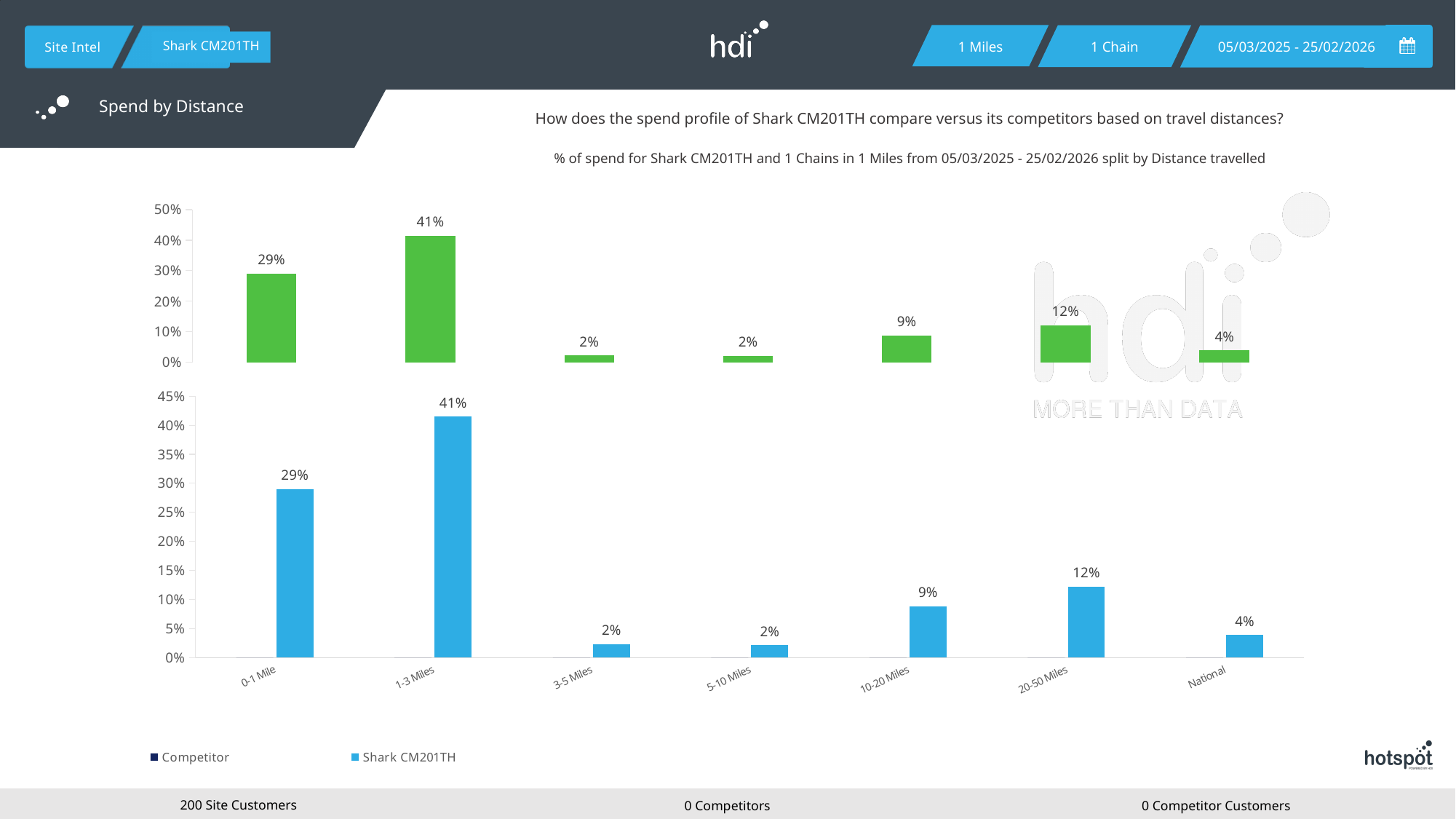
In the bottom chart, which distance band has the highest value? 1-3 Miles In the bottom chart, what is the value for 20-50 Miles? 12% In the bottom chart, what is the difference between the values for 1-3 Miles and 0-1 Mile? 12% How many distance categories are shown on the x axis of the bottom chart? 7 In the bottom chart, is the value for 0-1 Mile greater or less than 20%? greater What kind of chart is the bottom chart? bar chart In the bottom chart, what is the value for National? 4% What is the title of the slide section shown at the top left? Spend by Distance How many series does the legend list? 2 In the top chart, what is the highest value shown on a data label? 41% In the bottom chart, which is larger: the value for 10-20 Miles or the value for 20-50 Miles? 20-50 Miles In the bottom chart, what is the value for 0-1 Mile? 29%